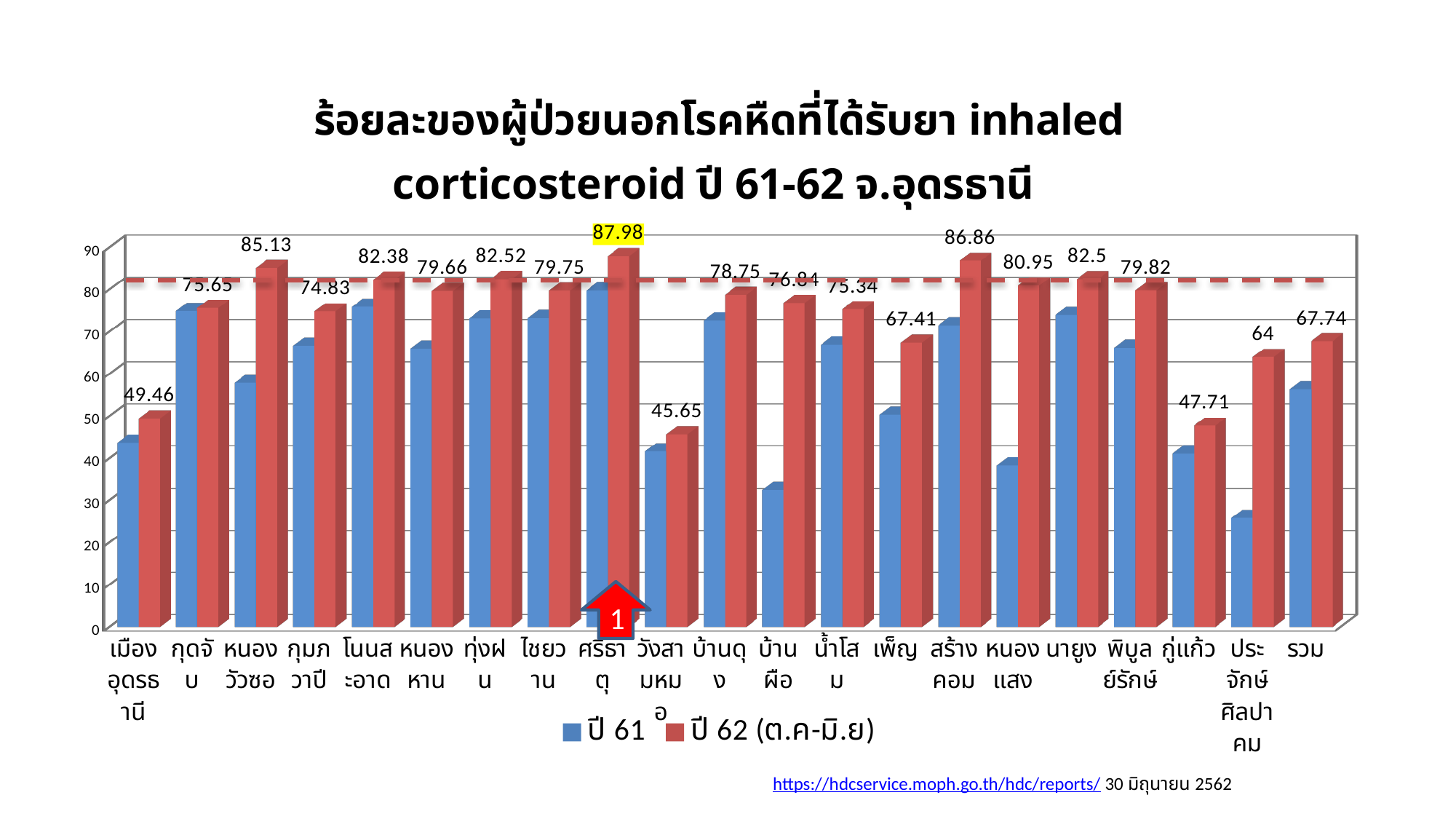
Which category has the lowest ปี 62 (ต.ค-มิ.ย) value? วังสามหมอ How many categories are shown on the x axis? 21 What is the ปี 62 (ต.ค-มิ.ย) value for รวม? 67.74 What is the difference between the ปี 62 (ต.ค-มิ.ย) values for ศรีธาตุ and วังสามหมอ? 42.33 Is the ปี 61 value for ประจักษ์ศิลปาคม greater or less than 30? less Which category has the highest ปี 62 (ต.ค-มิ.ย) value? ศรีธาตุ How many series does the legend list? 2 What is the ปี 62 (ต.ค-มิ.ย) value for ศรีธาตุ? 87.98 Is the ปี 61 value for บ้านผือ greater or less than 40? less What is the ปี 62 (ต.ค-มิ.ย) value for เมืองอุดรธานี? 49.46 Which has the larger ปี 62 (ต.ค-มิ.ย) value, หนองวัวซอ or กุมภวาปี? หนองวัวซอ What kind of chart is shown on the slide? bar chart